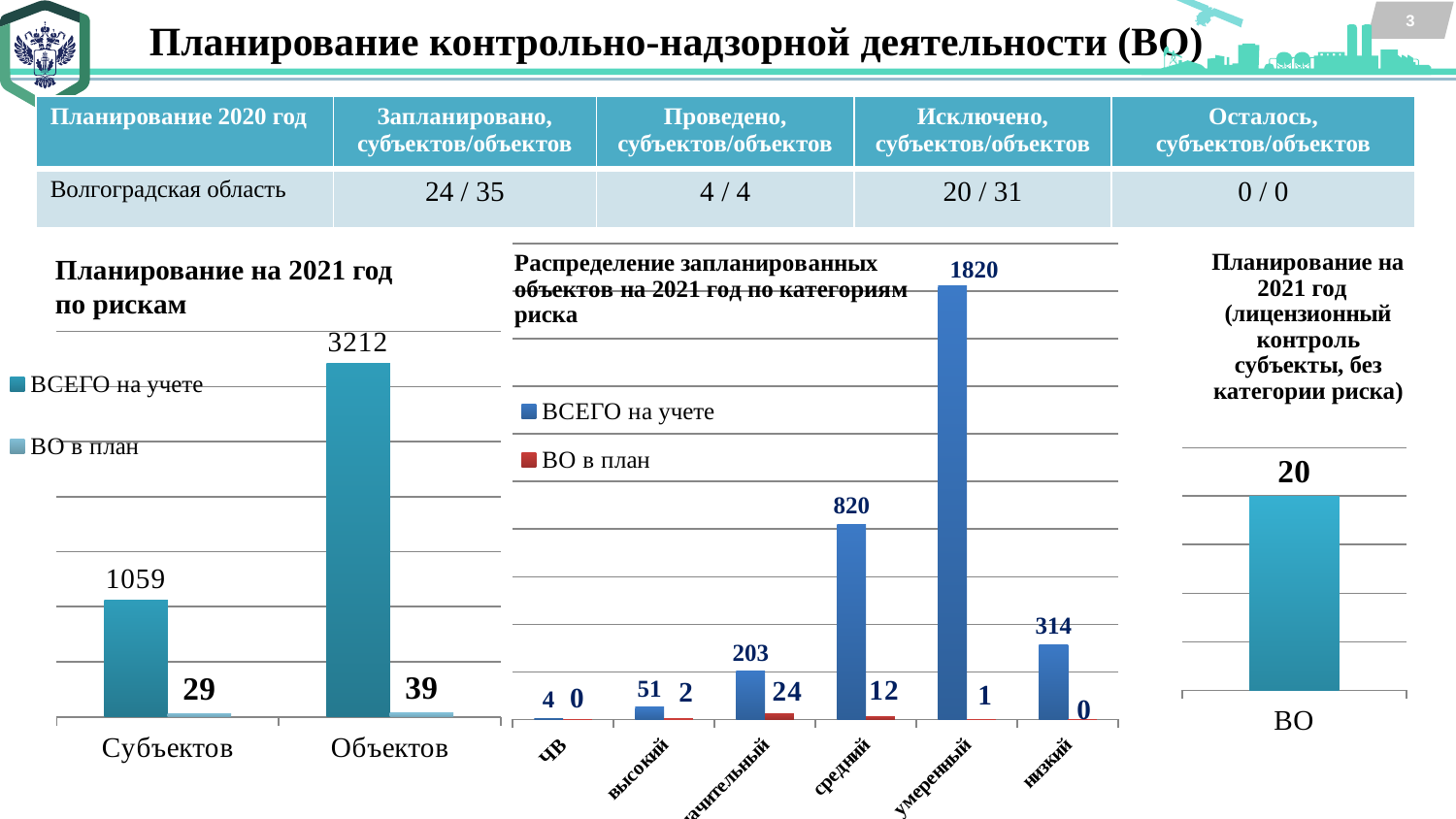
In the left chart 'Планирование на 2021 год по рискам', what is the value of 'ВО в план' for 'Субъектов'? 29 In the middle chart 'Распределение запланированных объектов на 2021 год по категориям риска', what is the 'ВО в план' value for 'умеренный'? 1 What type of chart is the right chart 'Планирование на 2021 год (лицензионный контроль субъекты, без категории риска)'? Bar chart In the middle chart 'Распределение запланированных объектов на 2021 год по категориям риска', which is larger: the 'ВСЕГО на учете' value for 'низкий' or for 'средний'? средний In the left chart 'Планирование на 2021 год по рискам', what is the value of 'ВСЕГО на учете' for 'Объектов'? 3212 In the middle chart 'Распределение запланированных объектов на 2021 год по категориям риска', how many categories are shown on the x axis? 6 In the left chart 'Планирование на 2021 год по рискам', what is the difference between 'ВСЕГО на учете' for 'Объектов' and for 'Субъектов'? 2153 In the middle chart 'Распределение запланированных объектов на 2021 год по категориям риска', what is the 'ВО в план' value for 'высокий'? 2 In the middle chart 'Распределение запланированных объектов на 2021 год по категориям риска', which category has the highest 'ВСЕГО на учете' value? умеренный In the middle chart 'Распределение запланированных объектов на 2021 год по категориям риска', what is the 'ВСЕГО на учете' value for 'средний'? 820 In the right chart 'Планирование на 2021 год (лицензионный контроль субъекты, без категории риска)', what is the value for 'ВО'? 20 In the left chart 'Планирование на 2021 год по рискам', how many series does the legend list? 2